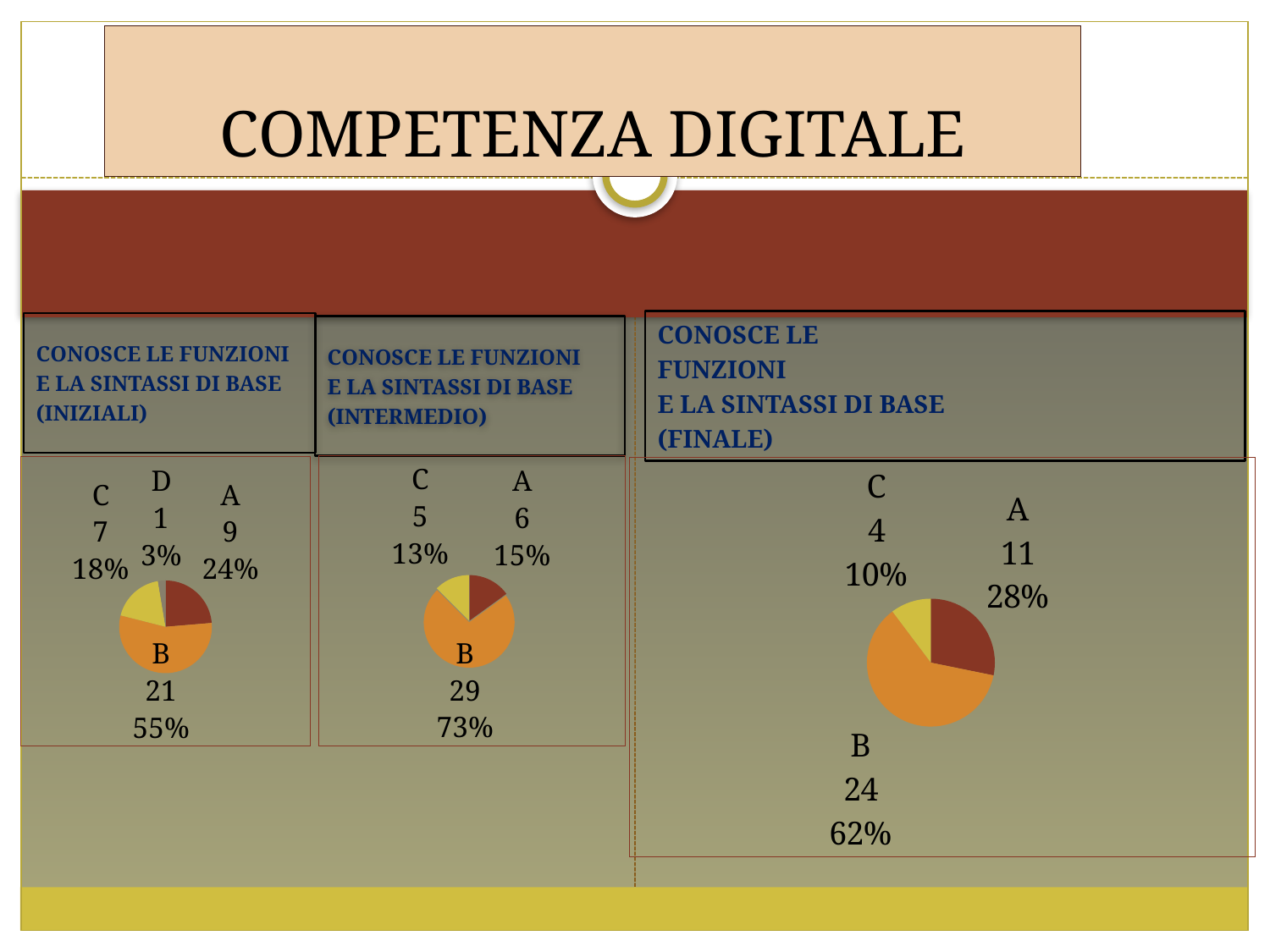
In the INTERMEDIO pie chart, what percentage share does category C have? 13% In the FINALE pie chart, what is the value for category A? 11 In the INIZIALI pie chart, which category has the lowest value? D In the FINALE pie chart, which category has the highest value? B What type of chart is used in the FINALE panel? Pie chart In the INIZIALI pie chart, what is the value for category B? 21 In the FINALE pie chart, which is larger, the value for A or the value for C? A How many categories are shown in the INTERMEDIO pie chart? 3 In the INTERMEDIO pie chart, what is the value for category B? 29 How many categories are shown in the INIZIALI pie chart? 4 In the INIZIALI pie chart, what percentage share does category D have? 3% In the INTERMEDIO pie chart, what is the difference between the values for B and A? 23